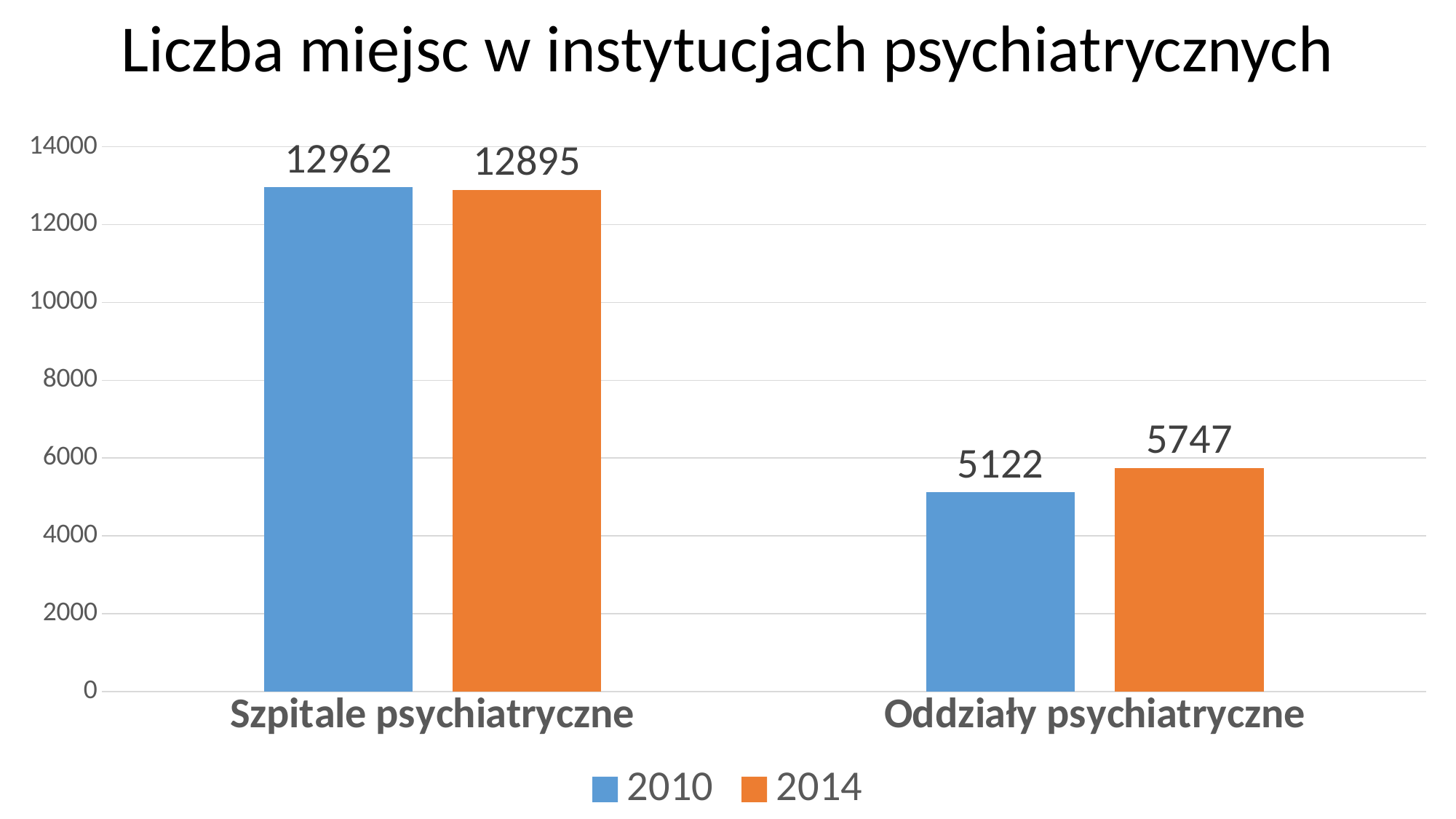
What is the value for Oddziały psychiatryczne in 2014? 5747 Which is larger for Oddziały psychiatryczne, the 2010 value or the 2014 value? 2014 What is the value for Oddziały psychiatryczne in 2010? 5122 What is the difference between the 2010 and 2014 values for Szpitale psychiatryczne? 67 How many categories are shown on the x axis? 2 What is the difference between the 2014 and 2010 values for Oddziały psychiatryczne? 625 What is the value for Szpitale psychiatryczne in 2010? 12962 Which category has the lowest value in 2014? Oddziały psychiatryczne Which category has the highest value in 2010? Szpitale psychiatryczne What kind of chart is shown on the slide? Bar chart How many series does the legend list? 2 What is the value for Szpitale psychiatryczne in 2014? 12895